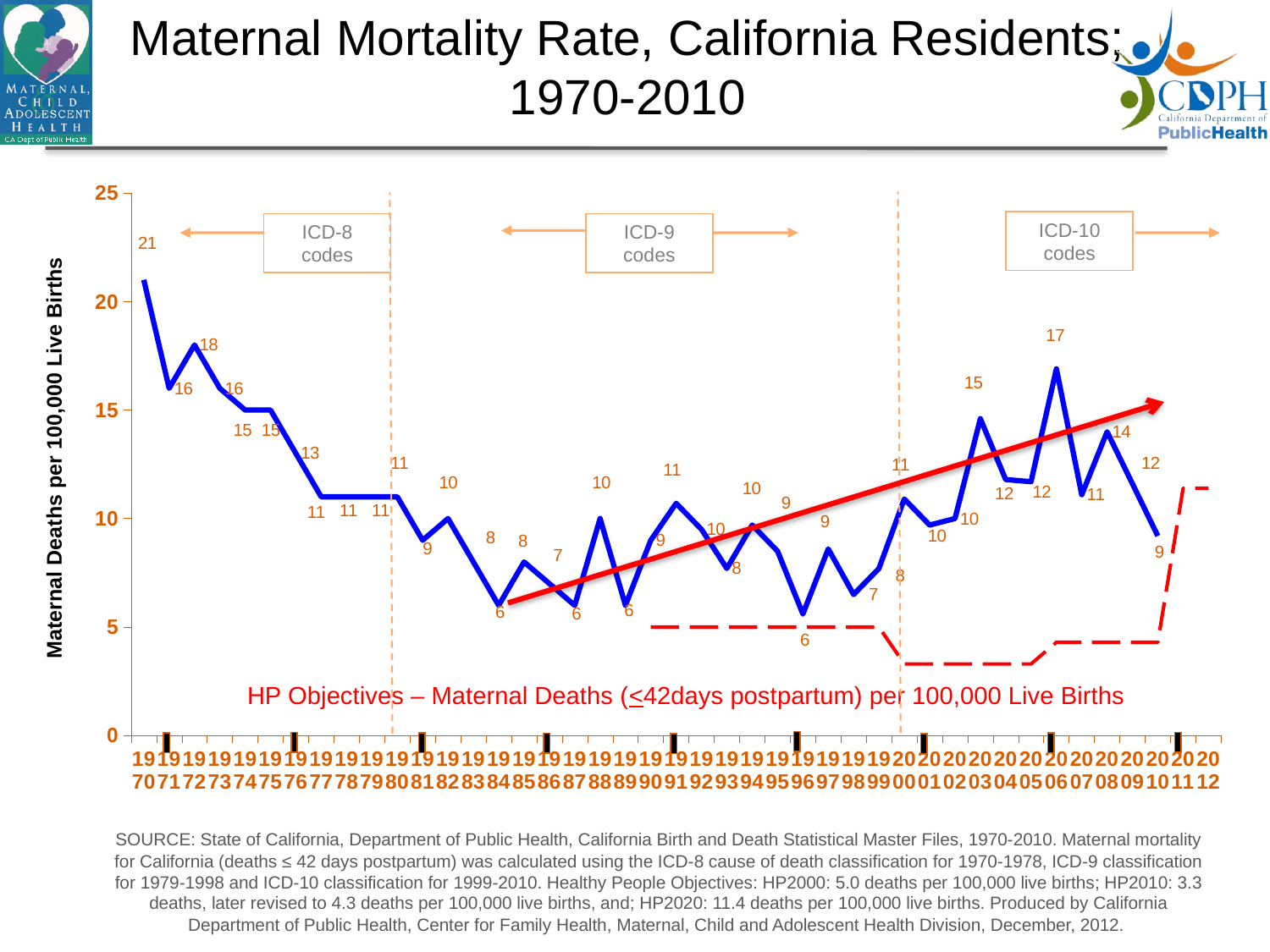
What is the maternal mortality rate plotted for 2006? 17 Which year has the highest maternal mortality rate on the chart? 1970 What is the difference between the maternal mortality rate in 1970 and in 2010? 12 What is the maternal mortality rate plotted for 2010? 9 Does the maternal mortality rate rise or fall from 1970 to 1984? Fall What kind of chart is shown on the slide? Line chart What is the difference between the maternal mortality rate in 2006 and in 2010? 8 What is the maternal mortality rate plotted for 2003? 15 What is the title of the vertical axis? Maternal Deaths per 100,000 Live Births What is the maternal mortality rate plotted for 1970? 21 What is the lowest maternal mortality rate value plotted on the chart? 6 Which year has a higher maternal mortality rate, 2003 or 2008? 2003